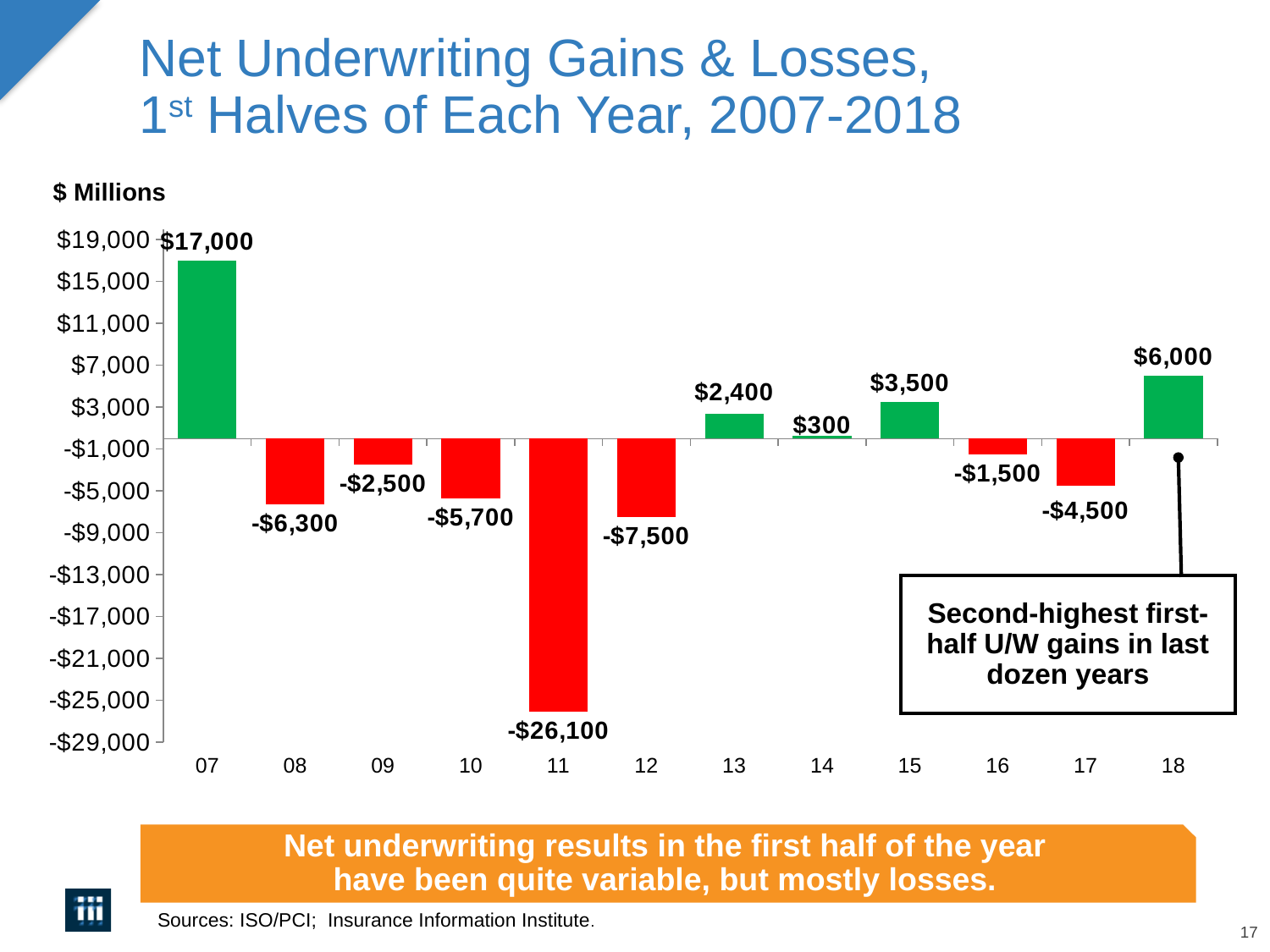
How many years are shown on the x axis? 12 What kind of chart is this? Bar chart What unit is stated above the chart's y axis? $ Millions What is the value shown for 2011? -$26,100 Which year has the lowest first-half net underwriting result? 11 What is the value shown for 2014? $300 What is the value shown for 2018? $6,000 What colour are the bars for years with losses? Red What is the net underwriting gain or loss for the first half of 2007? $17,000 What is the difference between the values for 2015 and 2013? $1,100 Which is larger, the value for 2008 or the value for 2010? 2010 Which year has the highest first-half net underwriting result? 07